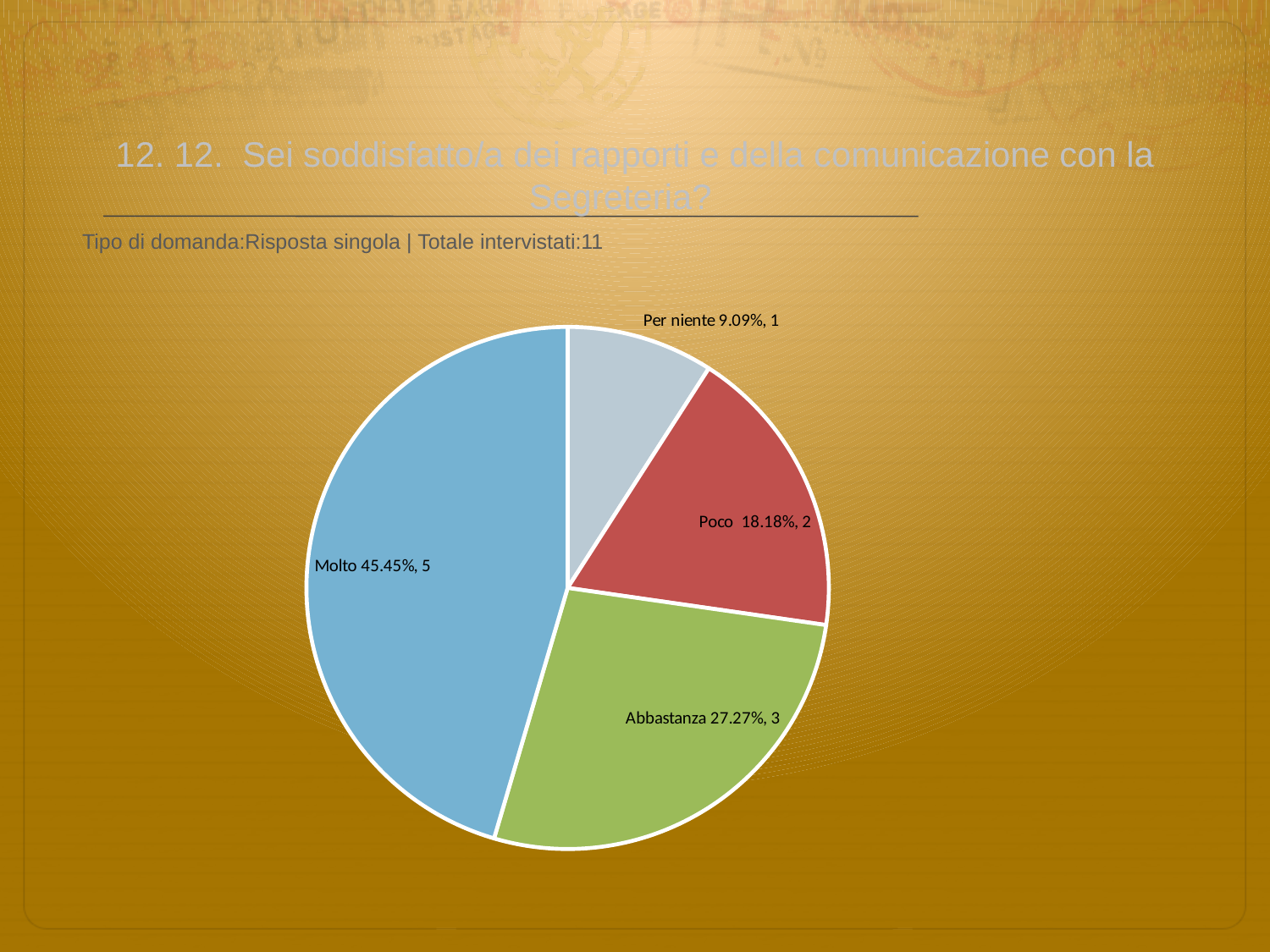
Which category has the smallest slice of the pie? Per niente Which category has the largest slice of the pie? Molto How many respondents answered 'Per niente'? 1 How many slices does the pie chart have? 4 What is the total number of respondents shown in the pie chart? 11 Which has more respondents, 'Poco' or 'Abbastanza'? Abbastanza What colour is the 'Molto' slice? blue How many respondents answered 'Abbastanza'? 3 What percentage share does the 'Molto' slice have? 45.45% What is the difference in respondent count between 'Molto' and 'Abbastanza'? 2 What kind of chart is shown on the slide? pie chart What percentage share does the 'Poco' slice have? 18.18%